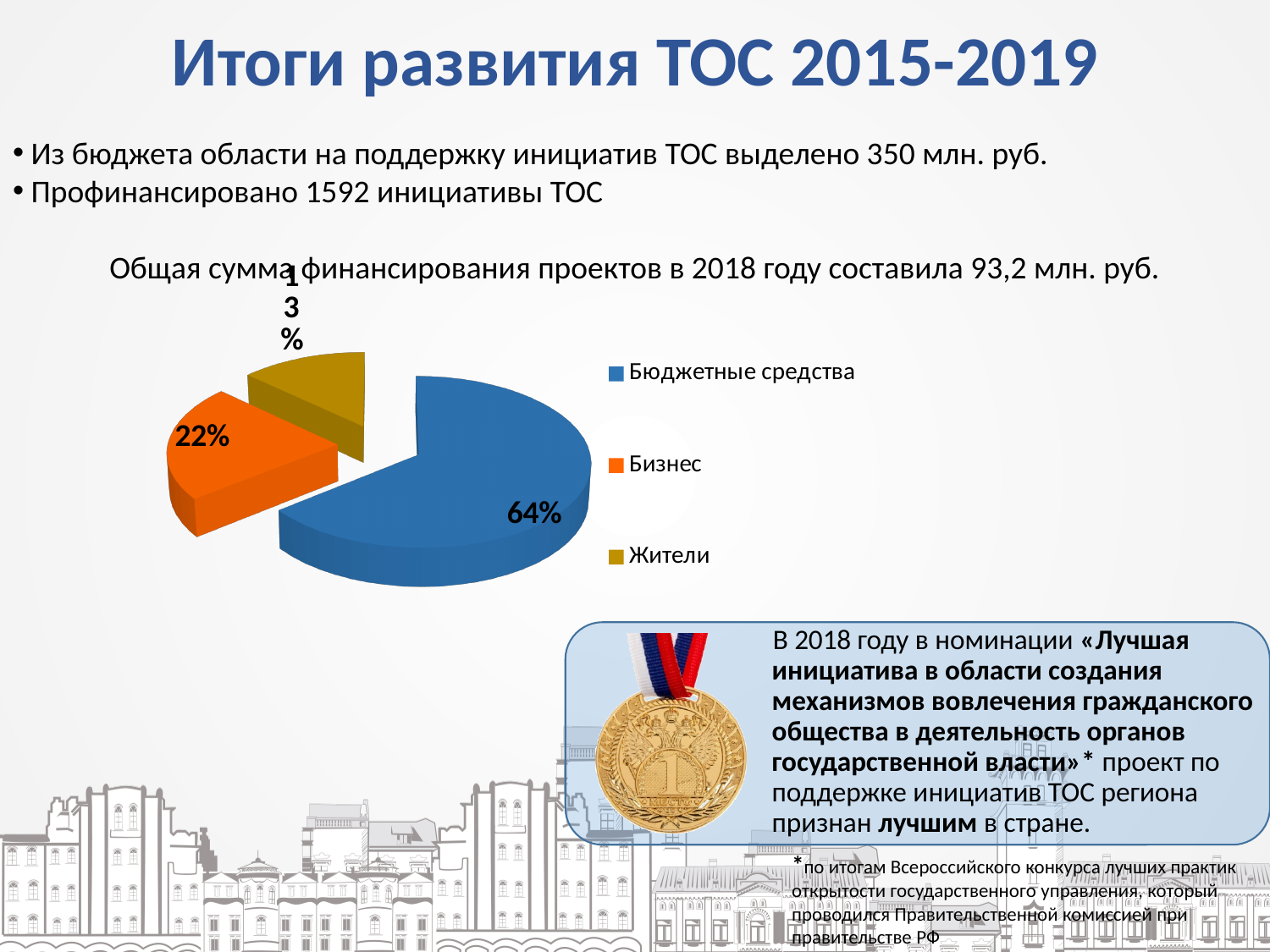
What is the difference in percentage points between Бюджетные средства and Бизнес? 42 What share of the pie does Бюджетные средства have? 64% What is the difference in percentage points between Бизнес and Жители? 9 What kind of chart is shown on the slide? pie chart Which is larger, the share for Бизнес or the share for Жители? Бизнес What share of the pie does Бизнес have? 22% How many entries does the legend list? 3 What share of the pie does Жители have? 13% Which category has the smallest slice of the pie? Жители How many slices does the pie chart have? 3 Which category has the largest slice of the pie? Бюджетные средства What colour is the slice for Бизнес? orange